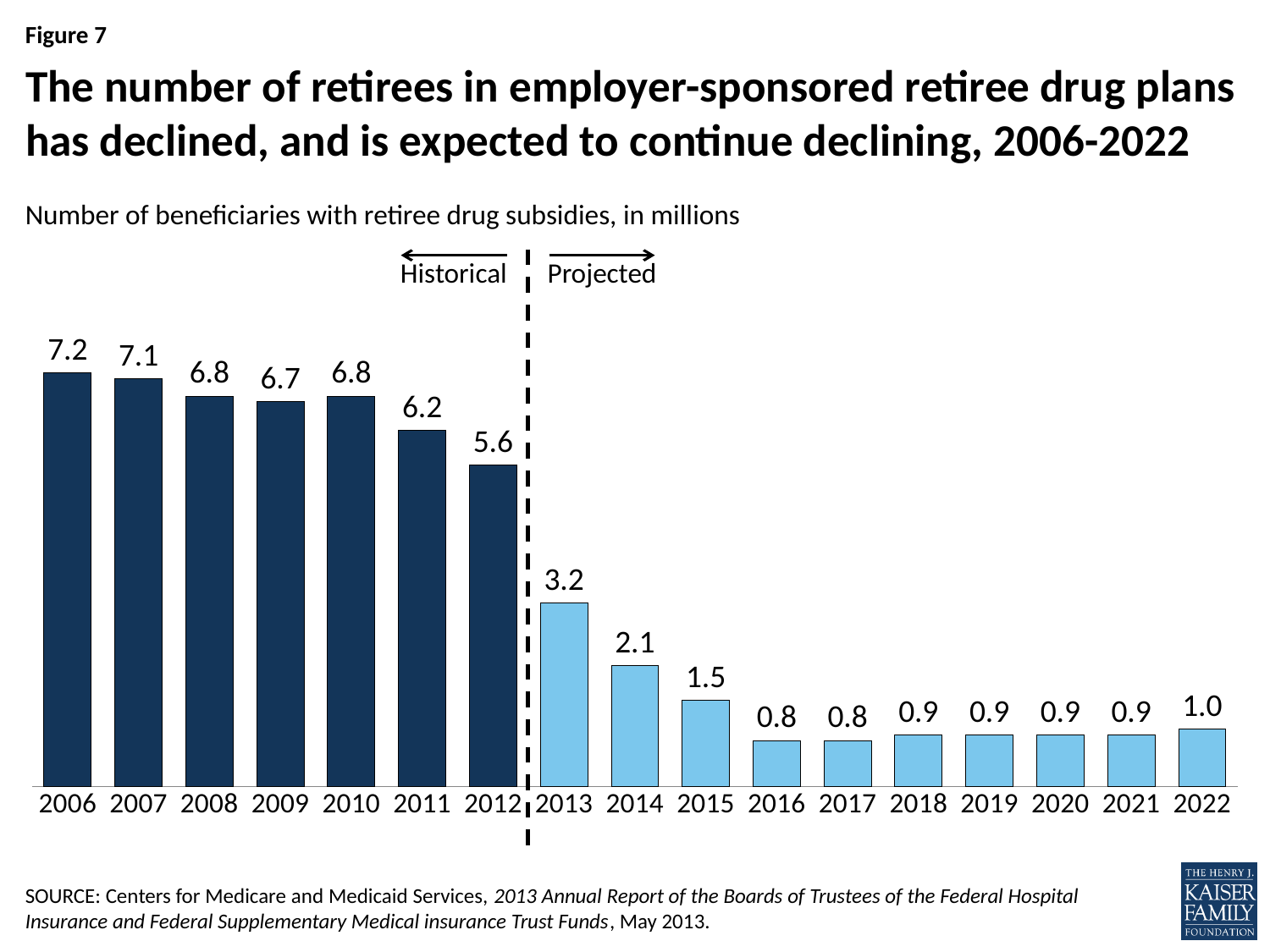
Which year is the first labeled as projected rather than historical? 2013 What is the value shown for 2012? 5.6 What is the projected value for 2022? 1.0 Which is larger, the value for 2011 or the value for 2014? 2011 What is the number of beneficiaries with retiree drug subsidies in 2006? 7.2 What is the difference between the values for 2012 and 2013? 2.4 What is the difference between the values for 2006 and 2012? 1.6 Which year has the highest value? 2006 How many years are shown on the x axis? 17 Do the values generally rise or fall from 2006 to 2016? Fall What kind of chart is this? Bar chart What is the projected value for 2013? 3.2